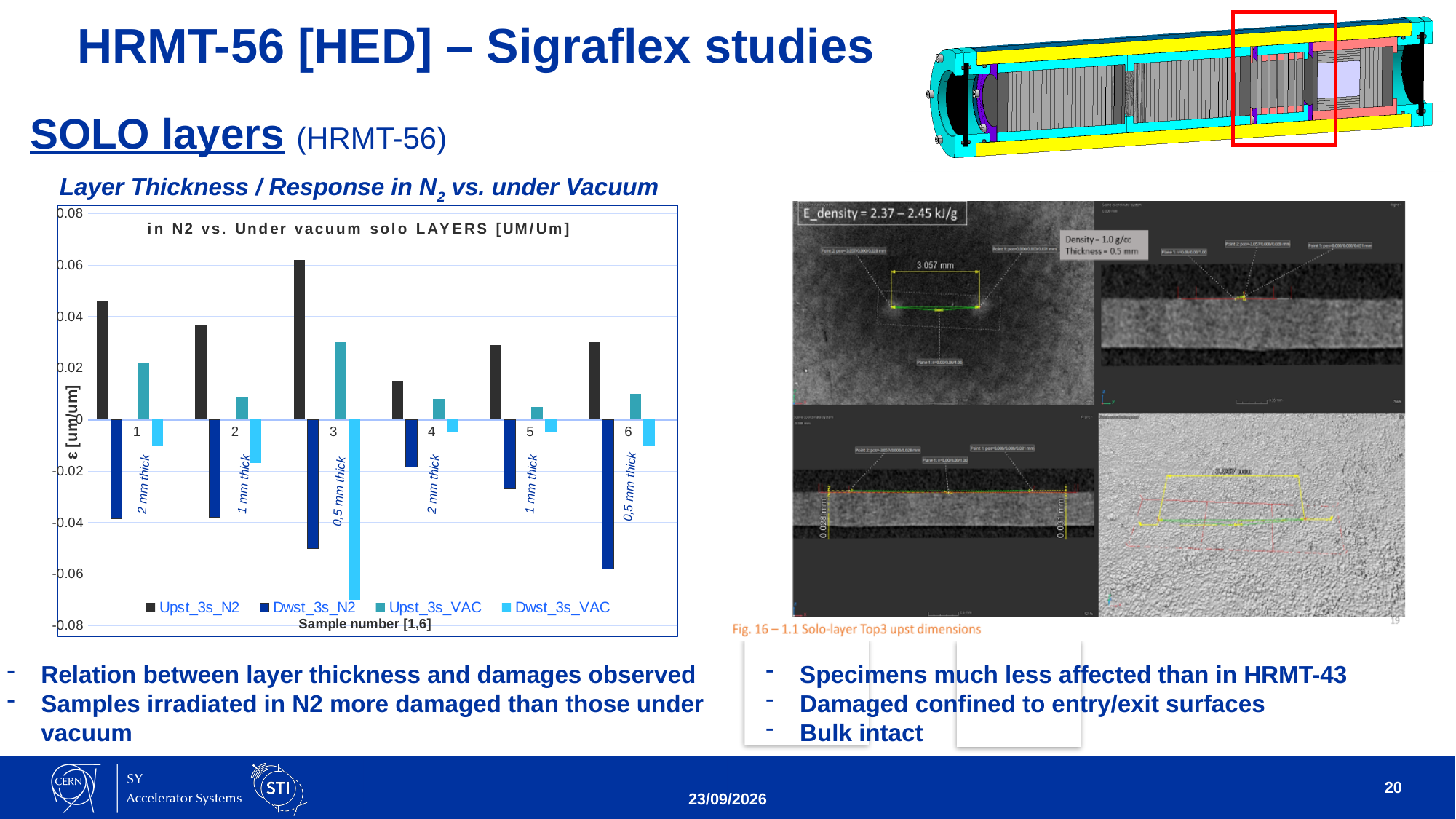
Which is larger for sample 1: the Upst_3s_N2 value or the Upst_3s_VAC value? Upst_3s_N2 Is the Dwst_3s_N2 value for sample 6 greater or less than -0.04? less How many sample numbers are shown along the x axis of the chart? 6 Is the Upst_3s_VAC value for sample 4 greater or less than 0.02? less Is the Upst_3s_N2 value for sample 1 greater or less than 0.04? greater How many series does the chart legend list? 4 What is the title printed inside the chart area? in N2 vs. Under vacuum solo LAYERS [UM/Um] For which sample number is the Dwst_3s_VAC value lowest (most negative)? 3 For which sample number is the Upst_3s_N2 value highest? 3 What kind of chart is shown on the slide? bar chart What layer thickness is annotated for sample 3 in the chart? 0,5 mm thick